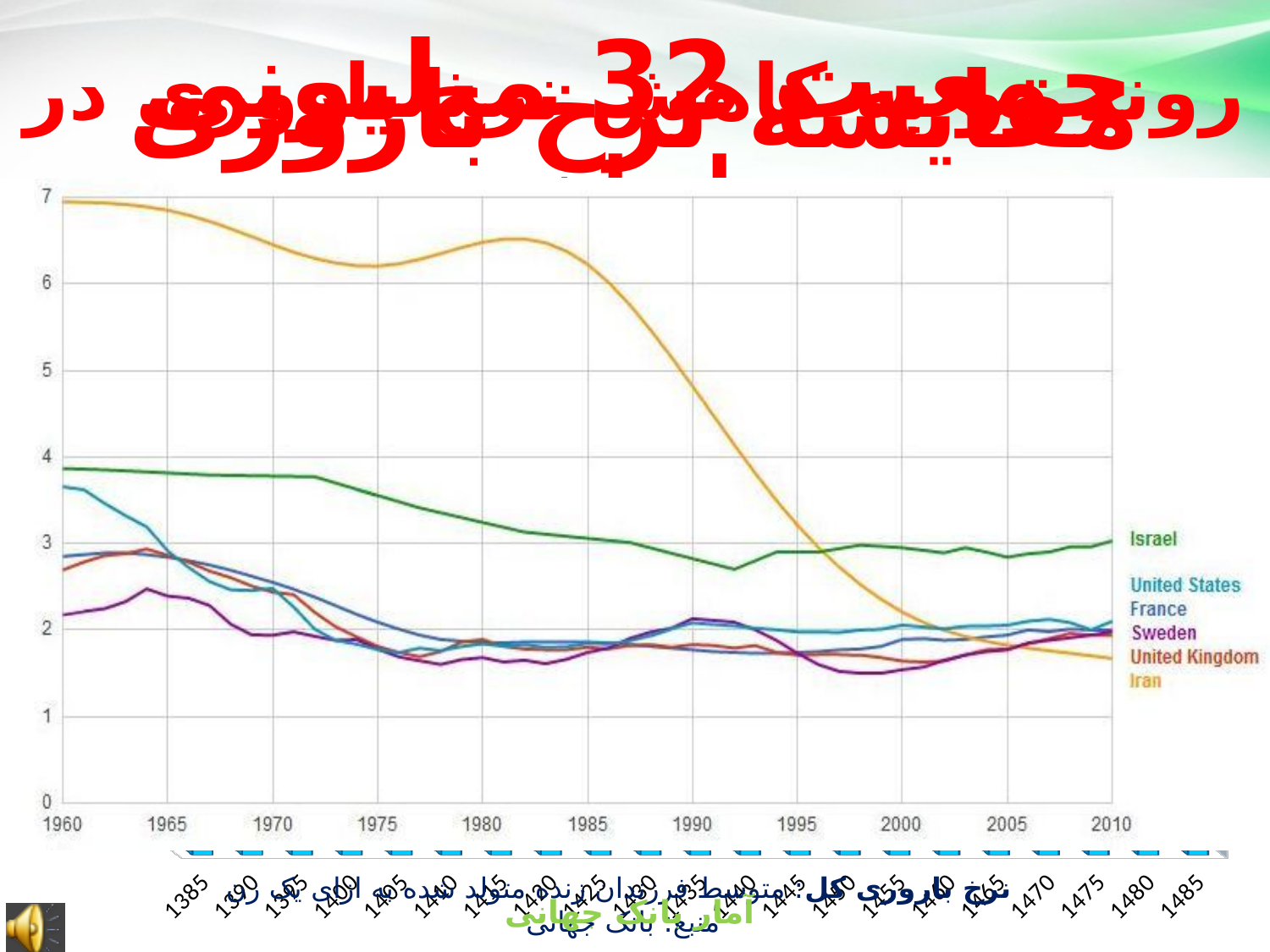
How many series does the legend list? 6 Which series has the highest value in 1960? Iran In 1960, which is larger: the value for the United States or the value for the United Kingdom? United States Is the value for Iran in 1960 greater or less than 6? greater Which countries are listed in the legend? Israel, United States, France, Sweden, United Kingdom, Iran Which series has the highest value in 2010? Israel Which series has the lowest value in 2010? Iran What kind of chart is shown on the slide? line chart Is the value for Iran in 1990 greater or less than 4? greater Is the value for Iran in 2010 greater or less than 2? less Does the Iran series rise or fall between 1985 and 2010? fall